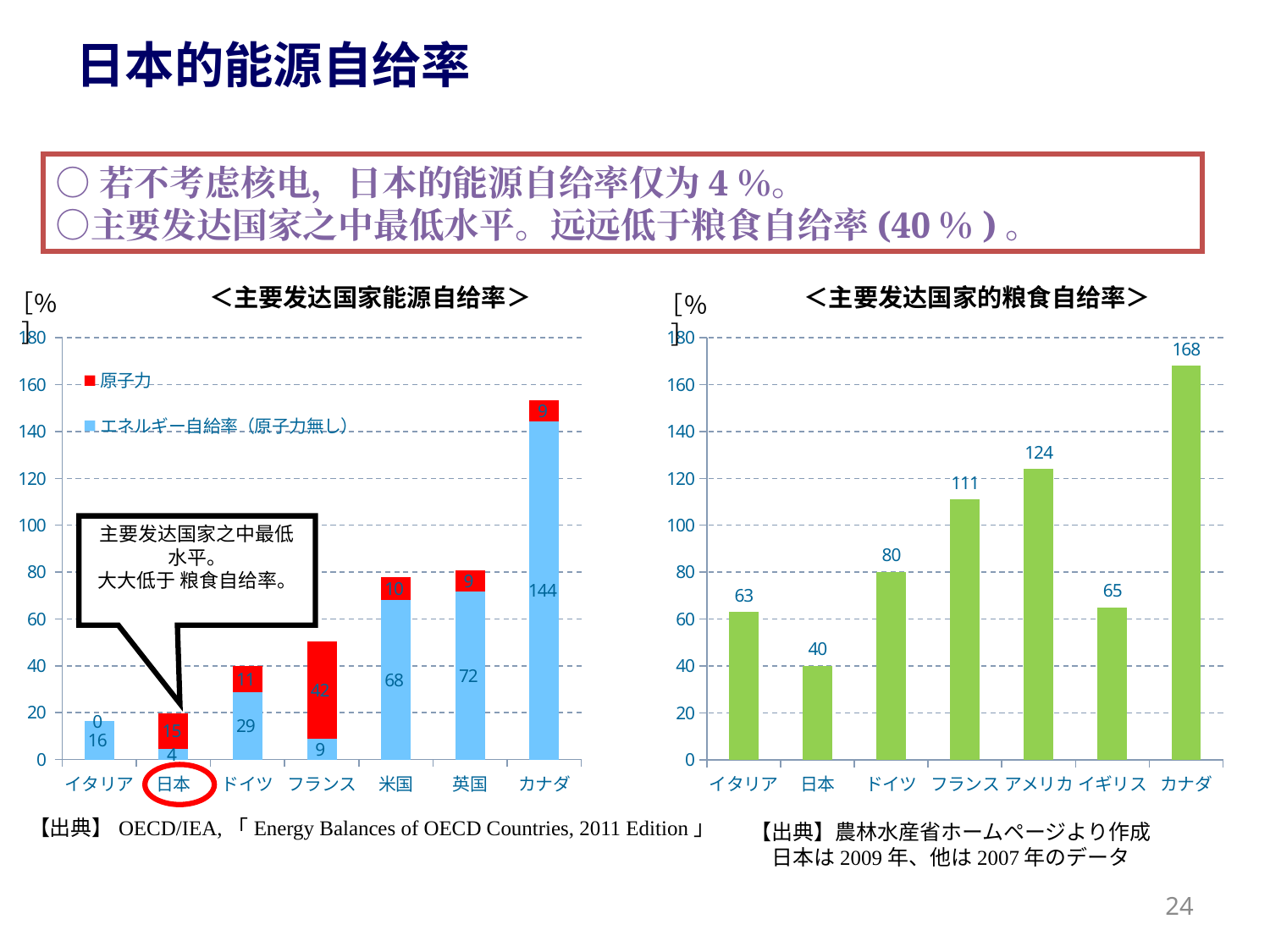
In the chart titled 主要发达国家的粮食自给率, which is larger, the value for イタリア or the value for イギリス? イギリス In the chart titled 主要发达国家能源自给率, what is the value of the 原子力 series for フランス? 42 In the chart titled 主要发达国家的粮食自给率, which country has the lowest value? 日本 In the chart titled 主要发达国家的粮食自给率, which country has the highest value? カナダ In the chart titled 主要发达国家能源自给率, what is the value of the エネルギー自給率（原子力無し） series for 日本? 4 In the chart titled 主要发达国家的粮食自给率, how many countries are shown? 7 In the chart titled 主要发达国家的粮食自给率, what is the value for 日本? 40 In the chart titled 主要发达国家的粮食自给率, what is the difference between the values for アメリカ and フランス? 13 What kind of chart is the chart titled 主要发达国家能源自给率? Stacked bar chart In the chart titled 主要发达国家能源自给率, which series is shown in red? 原子力 In the chart titled 主要发达国家能源自给率, how many series does the legend list? 2 In the chart titled 主要发达国家能源自给率, what is the total of the stacked bar for カナダ? 153